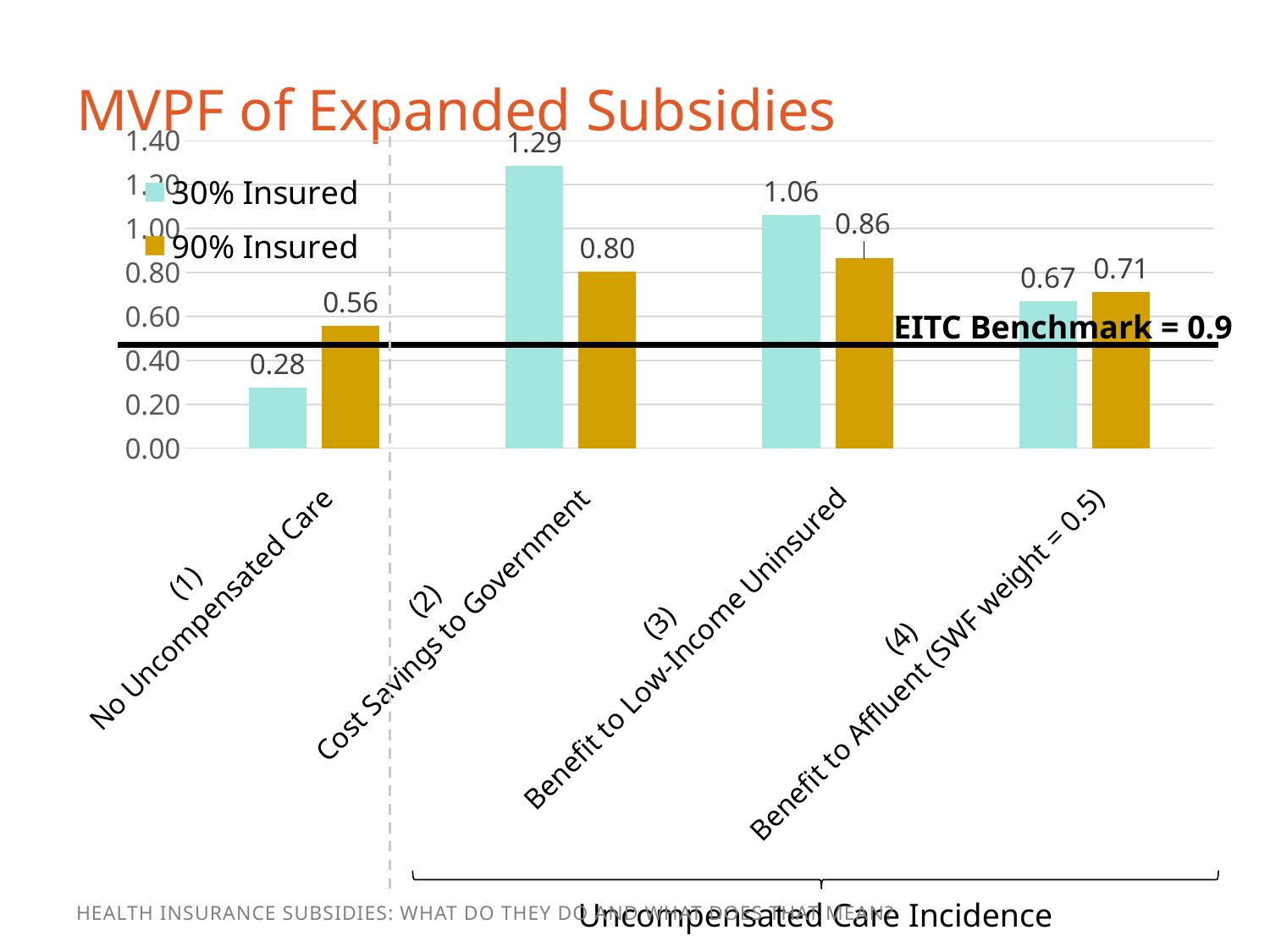
What kind of chart is shown on the slide? Bar chart What is the MVPF for the 30% Insured series under scenario (3) Benefit to Low-Income Uninsured? 1.06 Under scenario (3) Benefit to Low-Income Uninsured, which series has the larger MVPF, 30% Insured or 90% Insured? 30% Insured How many series does the legend list? 2 What is the MVPF for the 90% Insured series under scenario (4) Benefit to Affluent (SWF weight = 0.5)? 0.71 Which scenario has the highest MVPF for the 30% Insured series? (2) Cost Savings to Government What is the MVPF for the 30% Insured series under scenario (1) No Uncompensated Care? 0.28 What is the MVPF for the 90% Insured series under scenario (2) Cost Savings to Government? 0.80 What value does the EITC Benchmark line on the chart represent? 0.9 Which scenario has the lowest MVPF for the 90% Insured series? (1) No Uncompensated Care How many scenarios (categories) are shown on the x axis? 4 What is the difference between the 30% Insured and 90% Insured MVPF values under scenario (2) Cost Savings to Government? 0.49